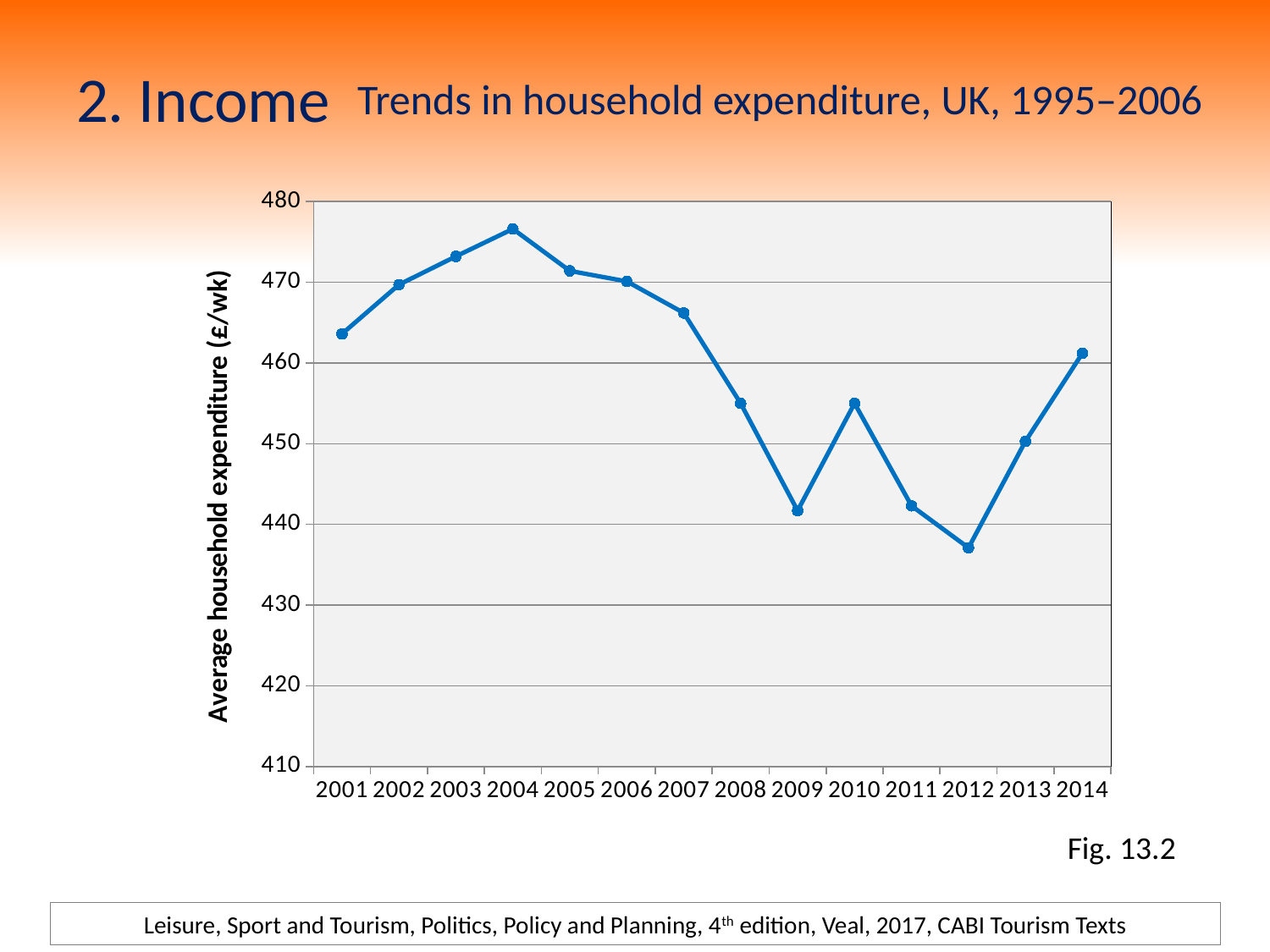
Do the values rise or fall from 2012 to 2014? rise Is the value for 2012 greater or less than 440? less What is the label on the y axis of the chart? Average household expenditure (£/wk) What kind of chart is shown on the slide? line chart Do the values rise or fall from 2004 to 2009? fall Is the value for 2007 greater or less than 470? less Is the value for 2004 greater or less than 470? greater Which year has the larger value, 2002 or 2011? 2002 Which year has the lowest average household expenditure? 2012 Which year has the highest average household expenditure? 2004 How many years are plotted on the x axis of the chart? 14